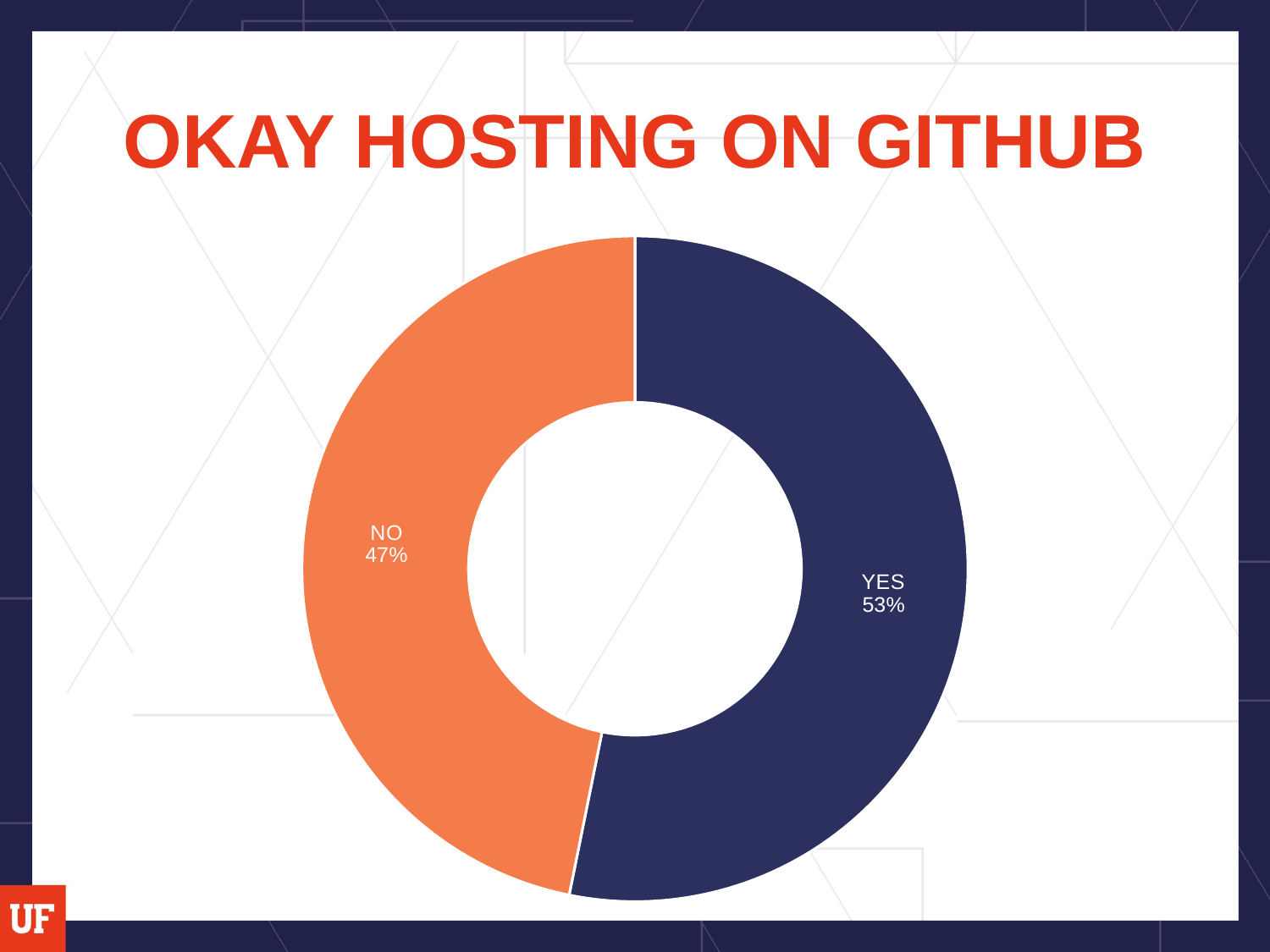
What is the difference in percentage points between YES and NO? 6 What share of the chart does the YES slice represent? 53% What colour is the NO slice? Orange Which category has the larger share, YES or NO? YES How many categories are shown in the chart? 2 What is the title of the slide? OKAY HOSTING ON GITHUB Which category has the smallest share? NO What percentage of respondents answered NO? 47% What kind of chart is shown on the slide? Doughnut (pie) chart What percentage of respondents answered YES? 53%